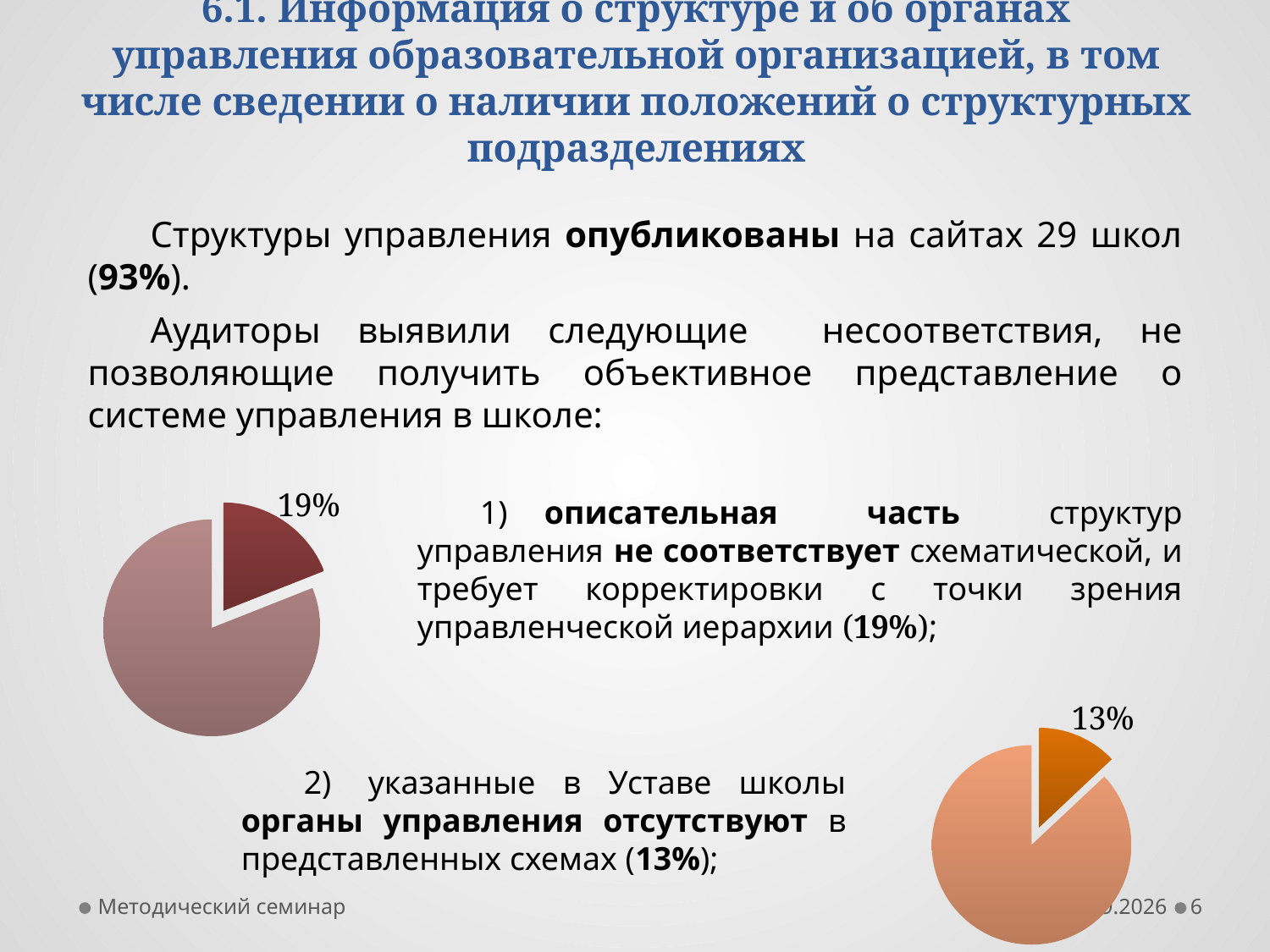
In the left pie chart, which slice is larger: the labelled 19% slice or the unlabelled slice? the unlabelled slice In the bottom-right pie chart, what percentage is shown on the exploded (separated) slice? 13% Which labelled slice is larger: the 19% slice in the left pie chart or the 13% slice in the bottom-right pie chart? the 19% slice in the left pie chart What kind of chart is the chart on the left side of the slide? pie chart In the left pie chart, what percentage is shown on the exploded (separated) slice? 19% What colour is the exploded slice in the left pie chart? dark red How many pie charts are shown on the slide? 2 How many slices does the bottom-right pie chart have? 2 What colour is the exploded slice in the bottom-right pie chart? orange What kind of chart is the chart in the bottom-right corner of the slide? pie chart How many slices does the left pie chart have? 2 In the bottom-right pie chart, which slice is smaller: the labelled 13% slice or the unlabelled slice? the 13% slice